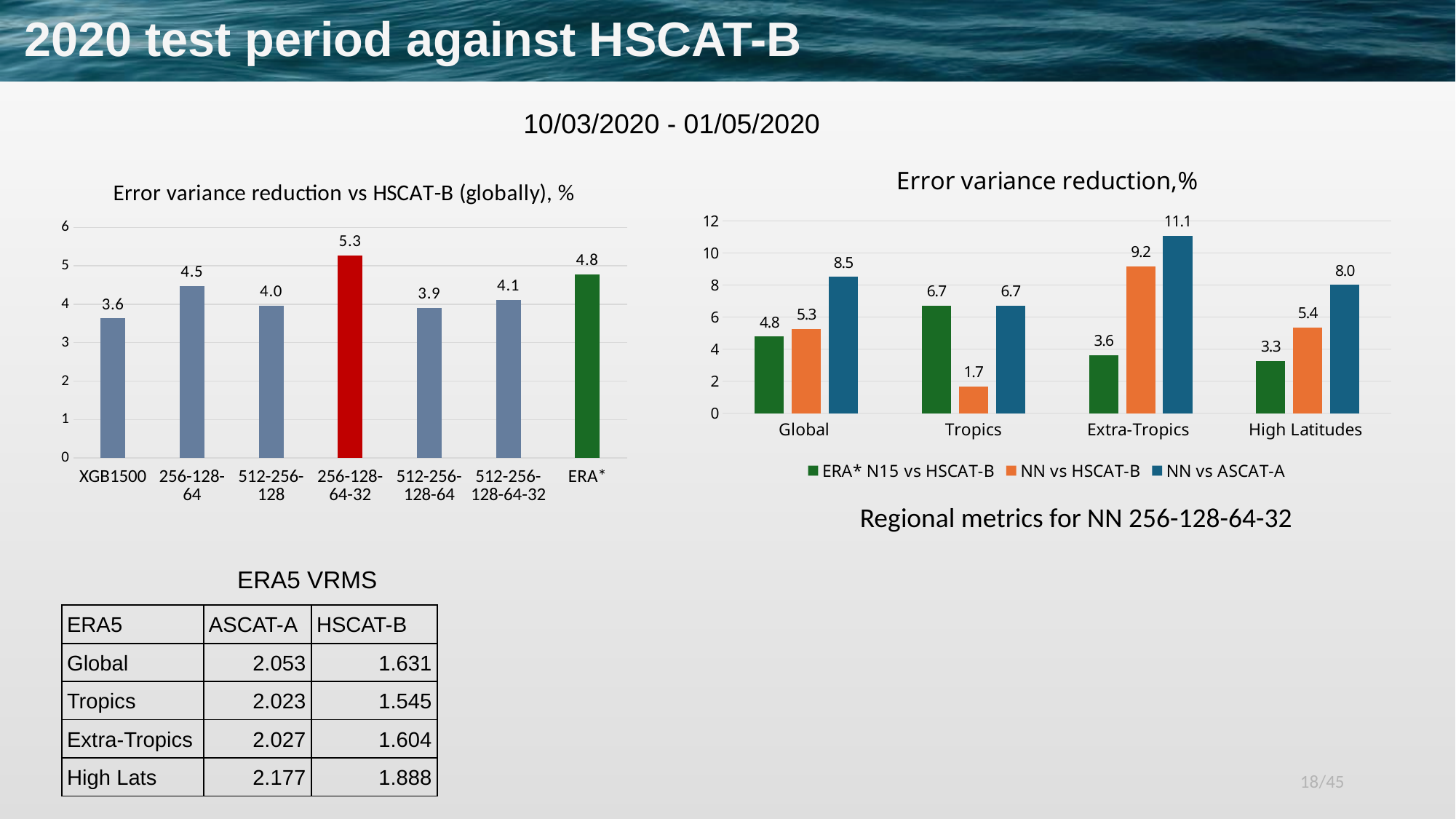
In the 'Error variance reduction vs HSCAT-B (globally), %' chart, how many categories are shown? 7 What kind of chart is the 'Error variance reduction,%' chart? Bar chart In the 'Error variance reduction,%' chart, which region has the lowest value for ERA* N15 vs HSCAT-B? High Latitudes In the 'Error variance reduction,%' chart, how many series does the legend list? 3 In the 'Error variance reduction vs HSCAT-B (globally), %' chart, which category has the lowest value? XGB1500 In the 'Error variance reduction vs HSCAT-B (globally), %' chart, which category has the highest value? 256-128-64-32 In the 'Error variance reduction vs HSCAT-B (globally), %' chart, what is the difference between the values for 256-128-64-32 and ERA*? 0.5 In the 'Error variance reduction,%' chart, what is the difference between NN vs ASCAT-A and ERA* N15 vs HSCAT-B for High Latitudes? 4.7 In the 'Error variance reduction vs HSCAT-B (globally), %' chart, which is larger, the value for 256-128-64 or the value for 512-256-128? 256-128-64 In the 'Error variance reduction,%' chart, what is the value of NN vs HSCAT-B for Tropics? 1.7 In the 'Error variance reduction vs HSCAT-B (globally), %' chart, what is the value for 256-128-64-32? 5.3 In the 'Error variance reduction,%' chart, what is the value of NN vs ASCAT-A for Extra-Tropics? 11.1